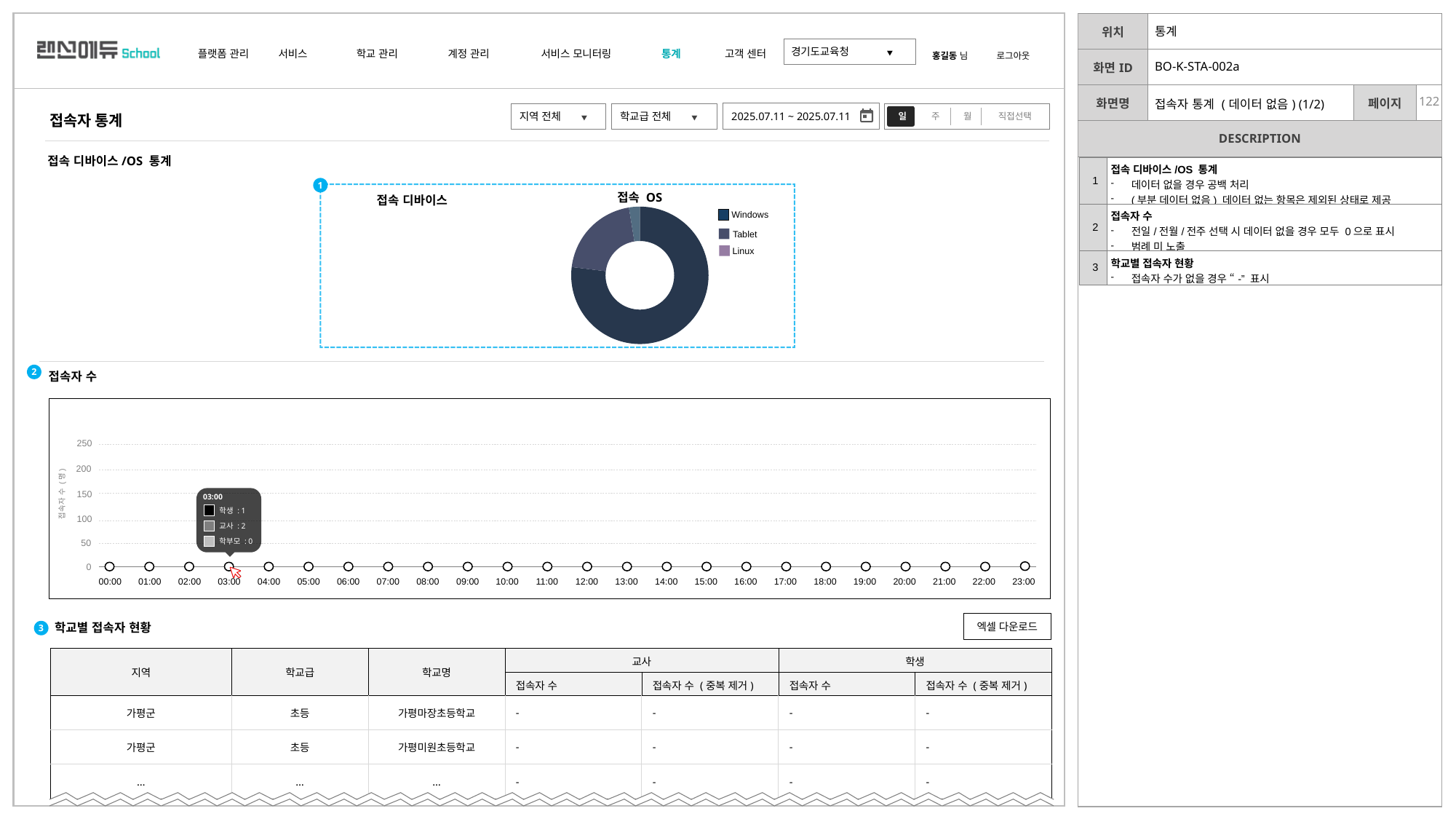
In the 접속자 수 chart, at 03:00 which is larger, the 교사 value or the 학생 value? 교사 In the 접속 OS chart, which category has the smallest slice? Linux In the 접속 OS chart, which category has the largest slice? Windows How many time points are plotted along the x axis of the 접속자 수 chart? 24 What kind of chart is the 접속자 수 chart? line chart In the 접속자 수 chart, is the value at 12:00 greater or less than 50? less What kind of chart is the 접속 OS chart? pie chart (donut) How many series does the legend of the 접속 OS chart list? 3 In the 접속자 수 chart, do the plotted values rise, fall, or stay flat from 00:00 to 23:00? stay flat In the 접속자 수 chart, what is the 교사 value shown in the tooltip at 03:00? 2 In the 접속자 수 chart, what is the 학생 value shown in the tooltip at 03:00? 1 Which entries appear in the legend of the 접속 OS chart? Windows, Tablet, Linux